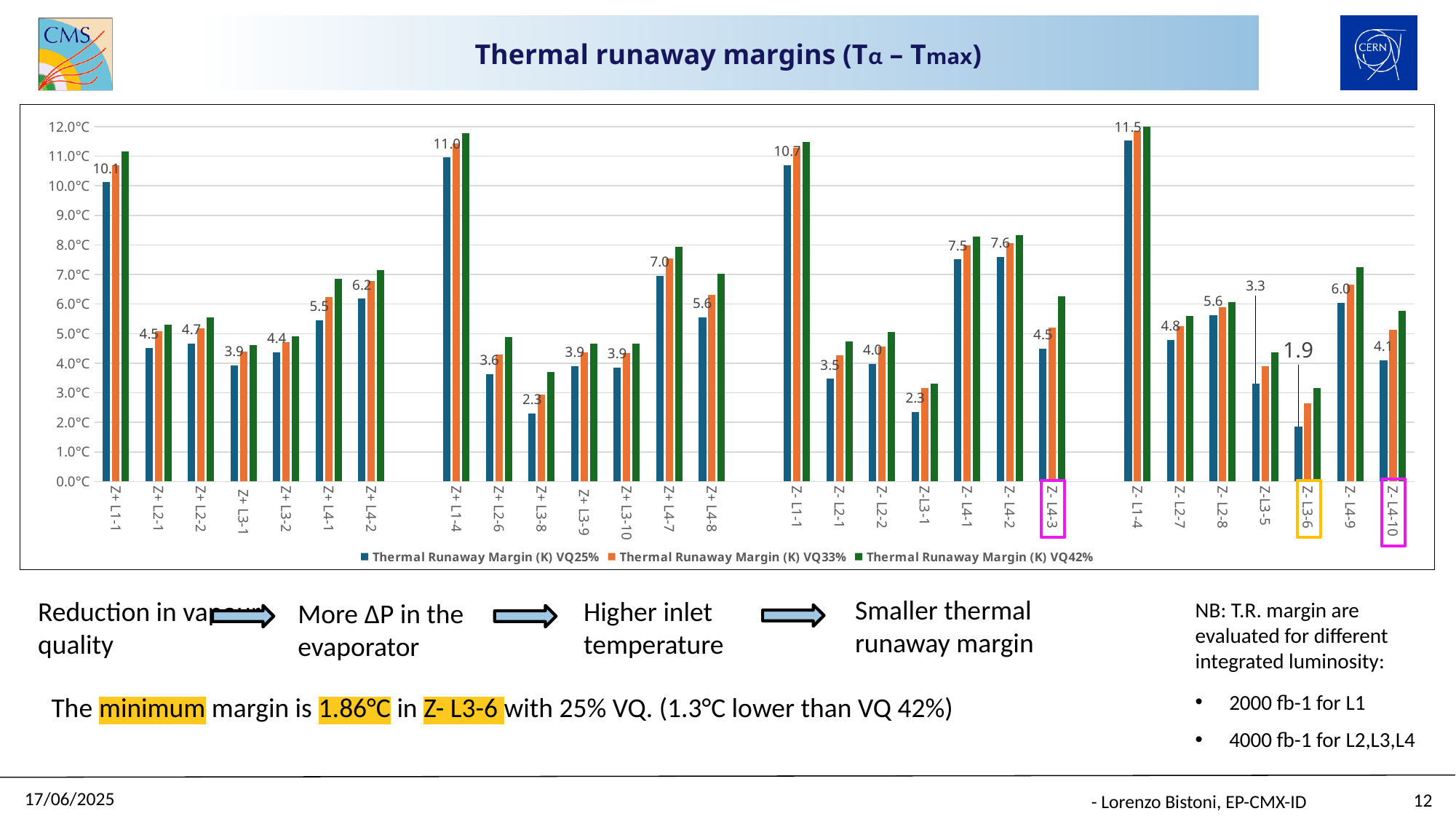
What is the Thermal Runaway Margin (K) VQ25% value for Z+ L1-1? 10.1 How many categories are shown on the x axis of the chart? 28 What is the difference between the VQ25% values for Z- L1-4 and Z+ L1-1? 1.4 Which category has the lowest Thermal Runaway Margin (K) VQ25% value? Z- L3-6 Which series is shown in green in the chart legend? Thermal Runaway Margin (K) VQ42% What is the Thermal Runaway Margin (K) VQ25% value for Z+ L4-7? 7.0 How many series does the legend list? 3 What kind of chart is shown on the slide? bar chart Which category has the highest Thermal Runaway Margin (K) VQ25% value? Z- L1-4 Is the Thermal Runaway Margin (K) VQ42% value for Z+ L1-4 greater or less than 11.0°C? greater What is the Thermal Runaway Margin (K) VQ25% value for Z- L3-6? 1.9 Which has a larger VQ25% value, Z+ L4-2 or Z- L4-9? Z+ L4-2